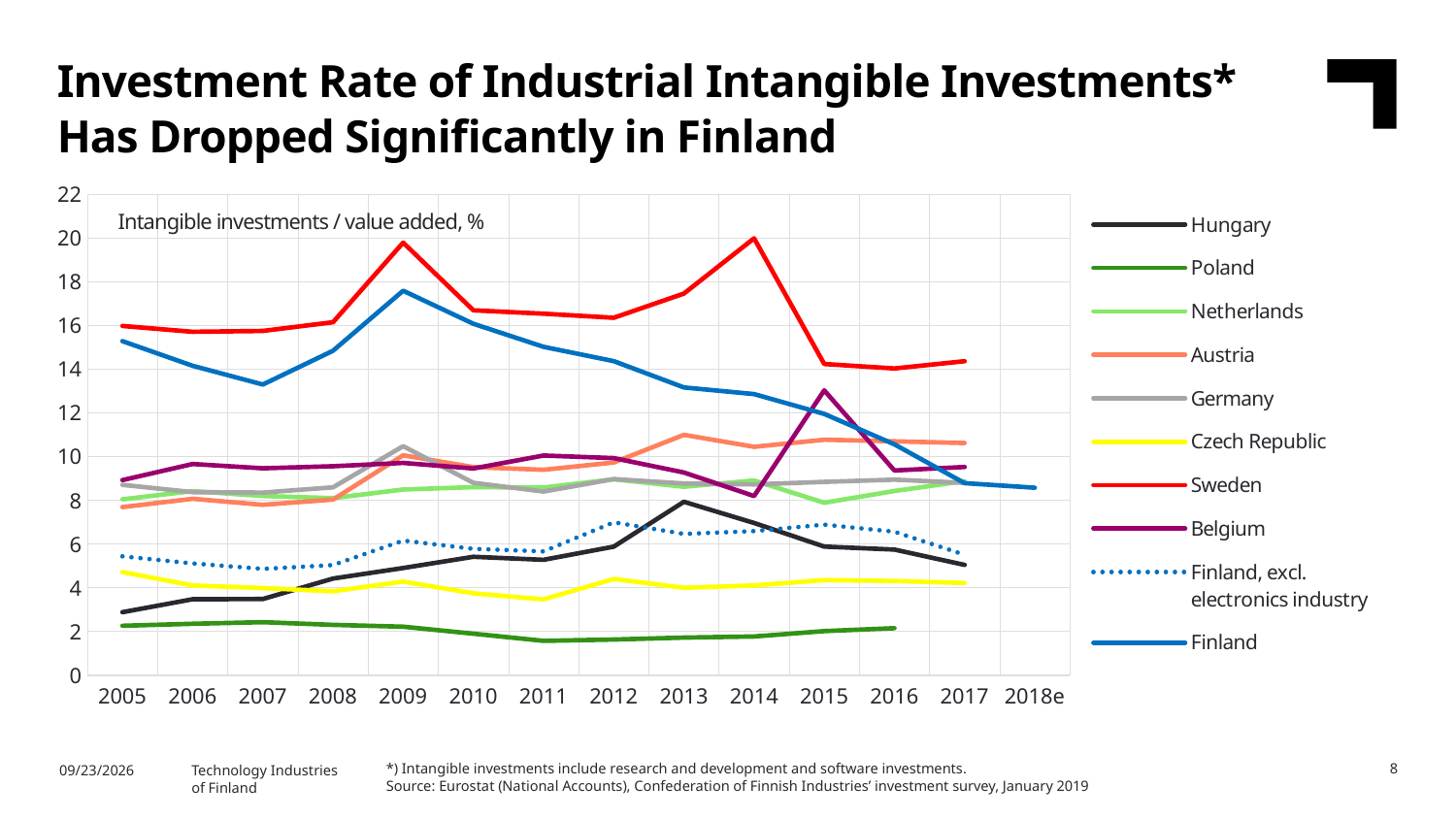
Which is larger in 2017, the value for Finland or the value for Hungary? Finland Is the value for Sweden in 2014 greater or less than 18? greater Does the value for Finland rise or fall from 2009 to 2018e? fall How many years are shown along the x axis? 14 How many series does the legend list? 10 What kind of chart is shown on the slide? line chart Is the value for Belgium in 2015 greater or less than 12? greater In which year does Finland reach its highest value? 2009 In which year does Sweden reach its highest value? 2014 Which country has the highest value in 2014? Sweden Is the value for Finland in 2018e greater or less than 10? less Which country has the lowest value in 2011? Poland